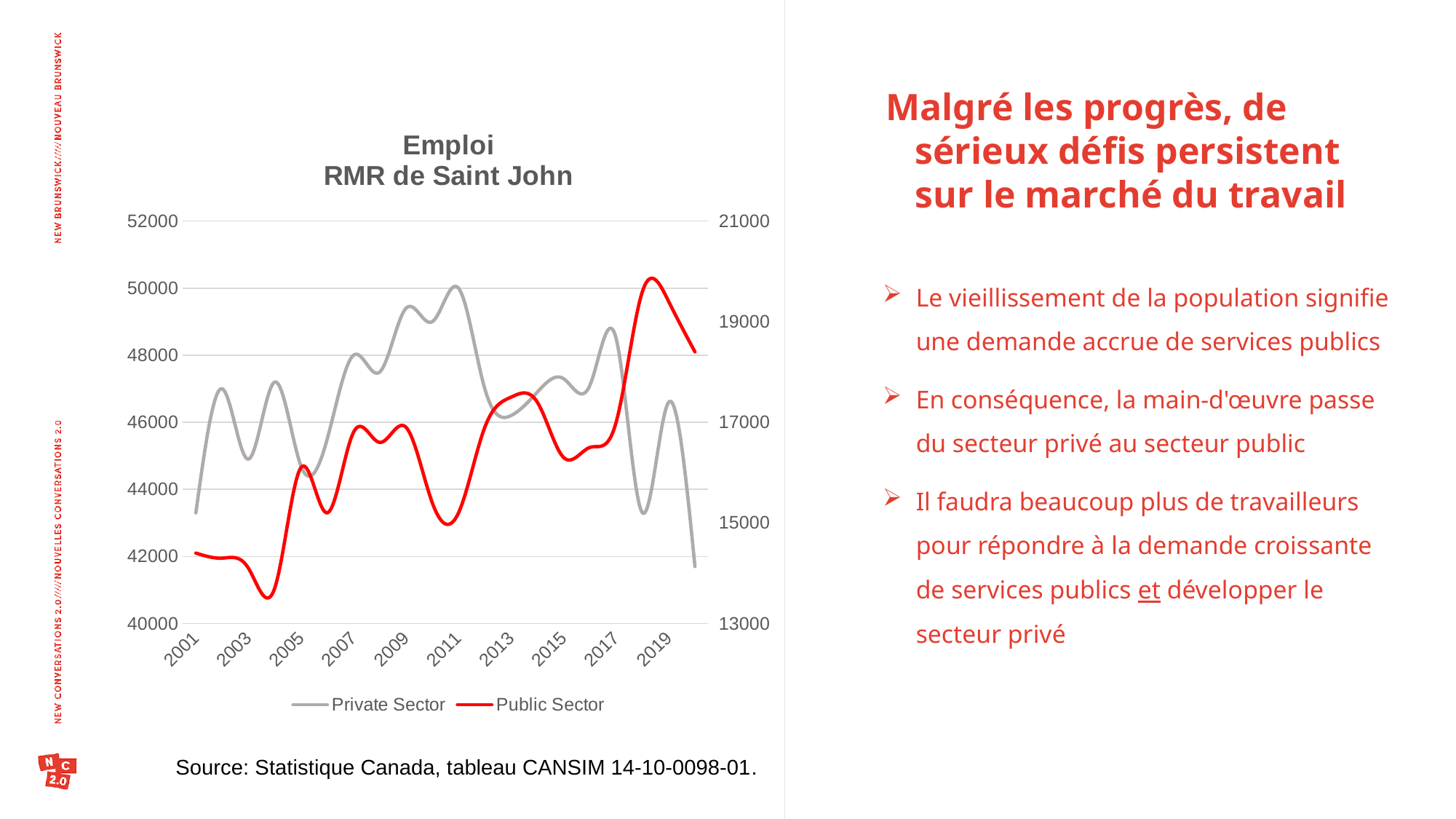
How many year labels are shown on the x axis? 10 Is the Public Sector value at its 2018 peak greater or less than 19000? greater Which is larger for the Public Sector: the value in 2001 or the value in 2019? 2019 Is the Private Sector value in 2019 greater or less than 46000? greater Is the Public Sector value in 2001 greater or less than 15000? less Which series is drawn in red? Public Sector Does the Private Sector line rise or fall between 2017 and the end of the series? fall What is the title of the chart? Emploi RMR de Saint John What kind of chart is shown on the slide? Line chart How many series does the legend list? 2 Overall, does the Public Sector line rise or fall from 2001 to 2019? rise